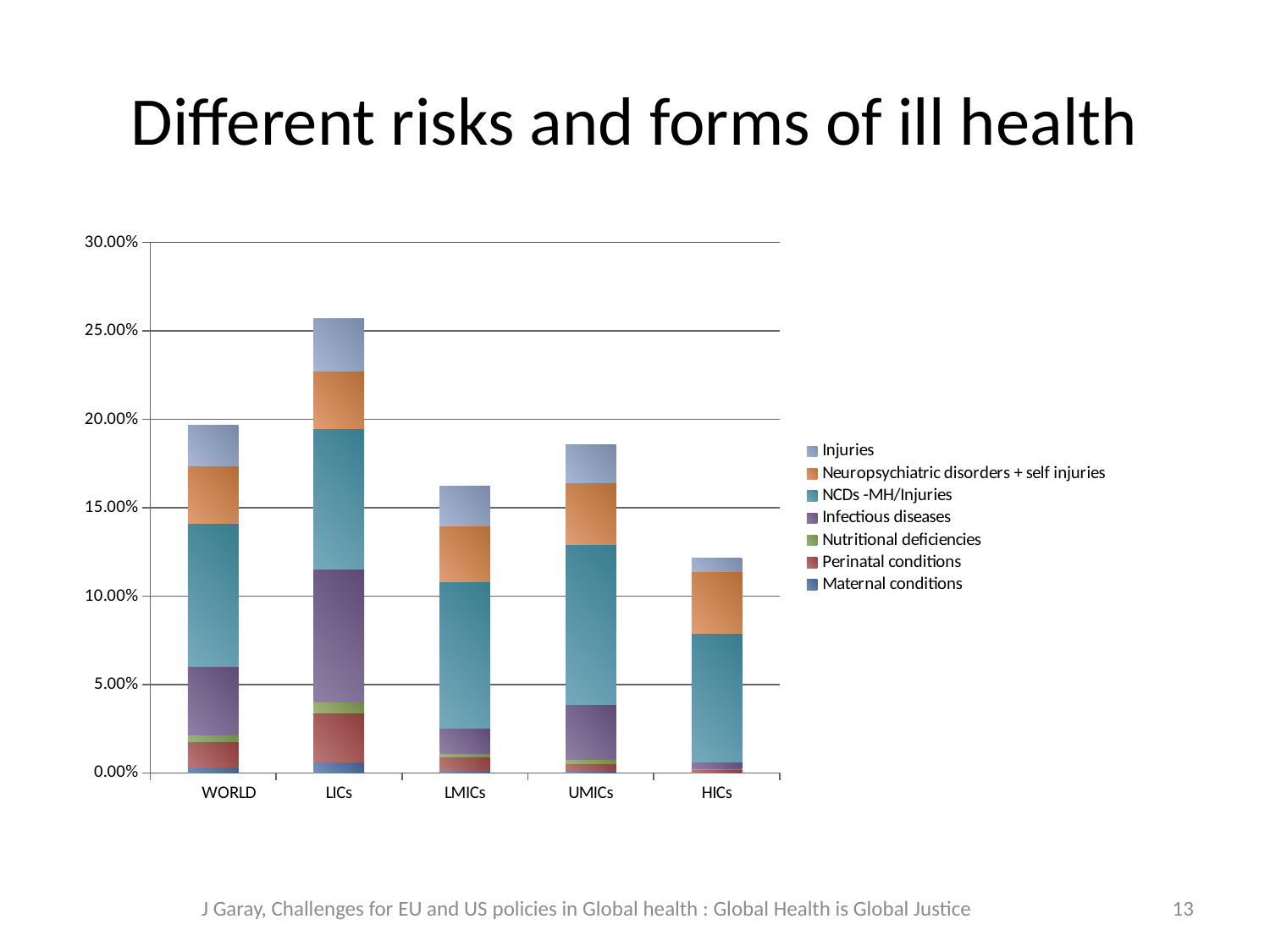
Is the total stacked value for WORLD greater or less than 15.00%? greater How many categories are shown along the x axis? 5 Is the total stacked value for LMICs greater or less than 20.00%? less How many series does the legend list? 7 Which category has the shortest stacked bar? HICs What is the title of the slide containing the chart? Different risks and forms of ill health Which series is listed first (at the top) in the legend? Injuries Which has the larger total stacked bar, UMICs or LMICs? UMICs Is the total stacked value for LICs greater or less than 20.00%? greater Which category has the tallest stacked bar? LICs What kind of chart is shown on the slide? Stacked bar chart